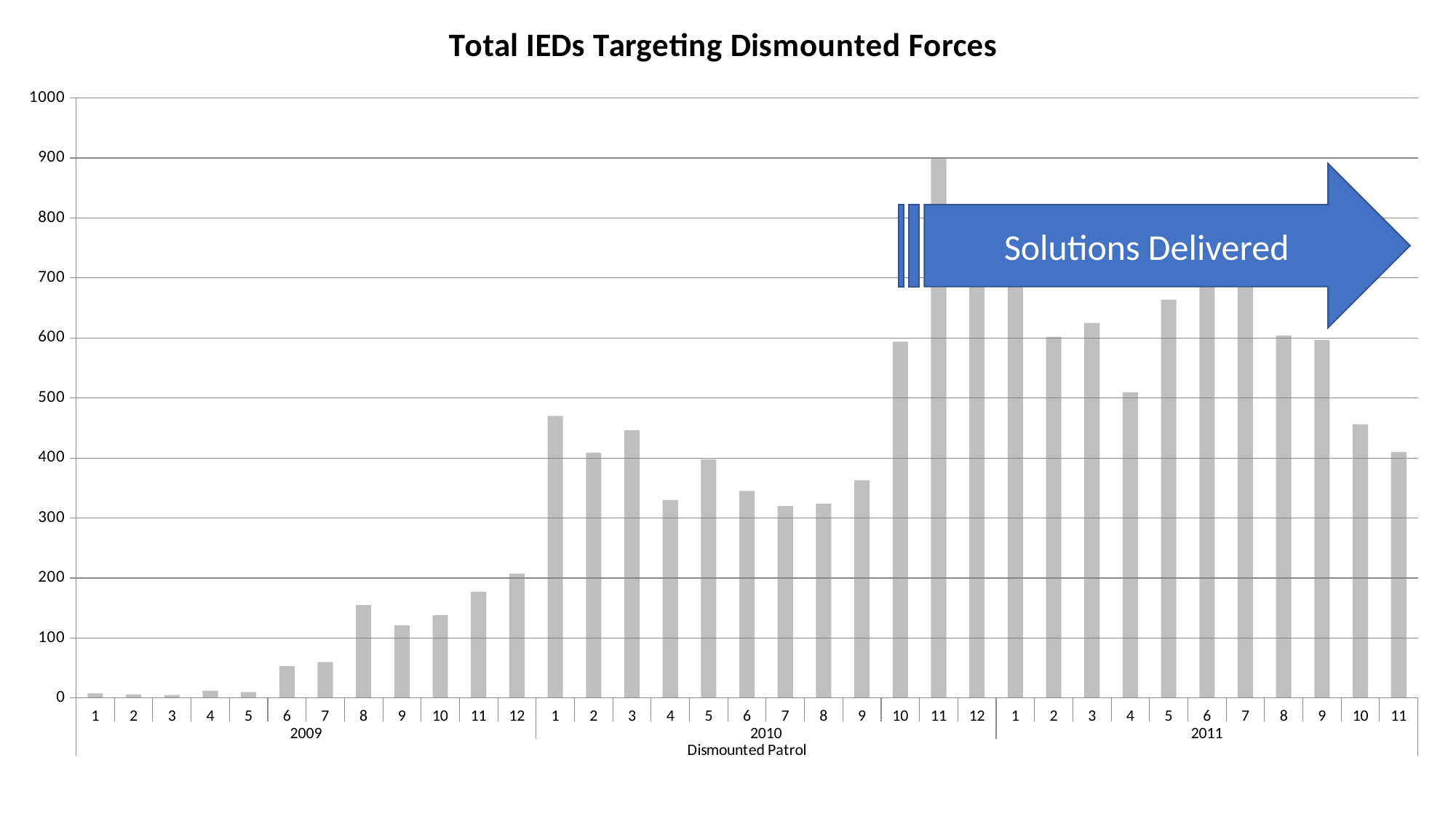
Is the value for month 1 of 2010 greater or less than 400? greater What text is written inside the blue arrow on the chart? Solutions Delivered Do the values generally rise or fall across the months of 2009? rise How many monthly bars are plotted on the chart in total? 35 Which is larger, the value for month 1 of 2010 or the value for month 2 of 2010? Month 1 of 2010 Is the value for month 10 of 2011 greater or less than 500? less Which month has the highest bar on the chart? Month 11 of 2010 Is the value for month 8 of 2009 greater or less than 100? greater What is the title of the chart? Total IEDs Targeting Dismounted Forces How many months are plotted for 2011? 11 What kind of chart is shown on the slide? bar chart